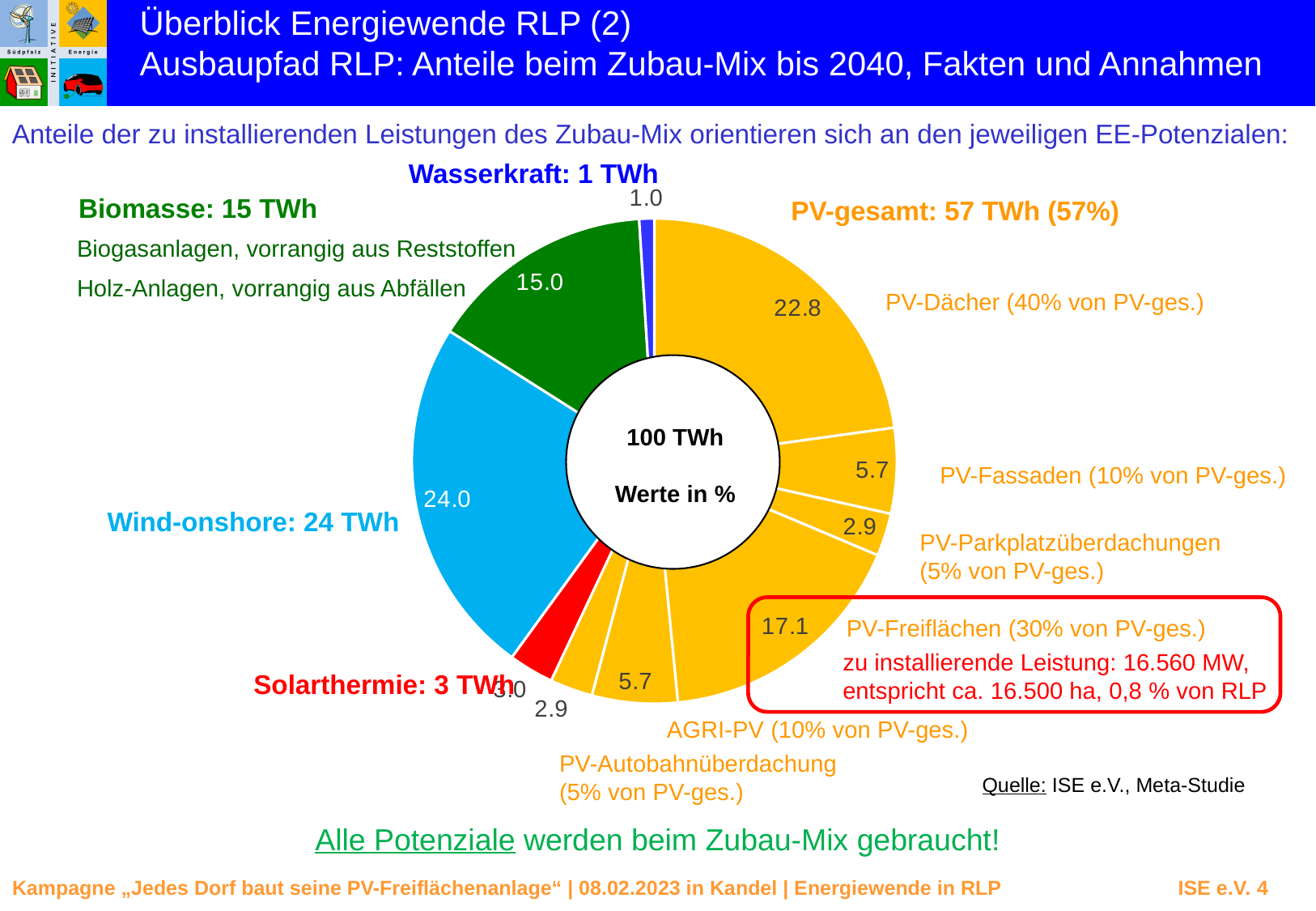
What value is shown for the PV-Dächer segment? 22.8 What kind of chart is shown on the slide? Pie (doughnut) chart What text is printed in the centre of the chart? 100 TWh, Werte in % Which is larger, the PV-Freiflächen segment or the Biomasse segment? PV-Freiflächen What value is shown for the Biomasse segment? 15.0 What value is shown for the PV-Freiflächen segment? 17.1 What value is shown for the Wasserkraft segment? 1.0 How many segments does the chart have? 10 Which segment has the smallest value? Wasserkraft What value is shown for the Wind-onshore segment? 24.0 Which segment has the largest value? Wind-onshore What is the difference between the Wind-onshore value and the Biomasse value? 9.0